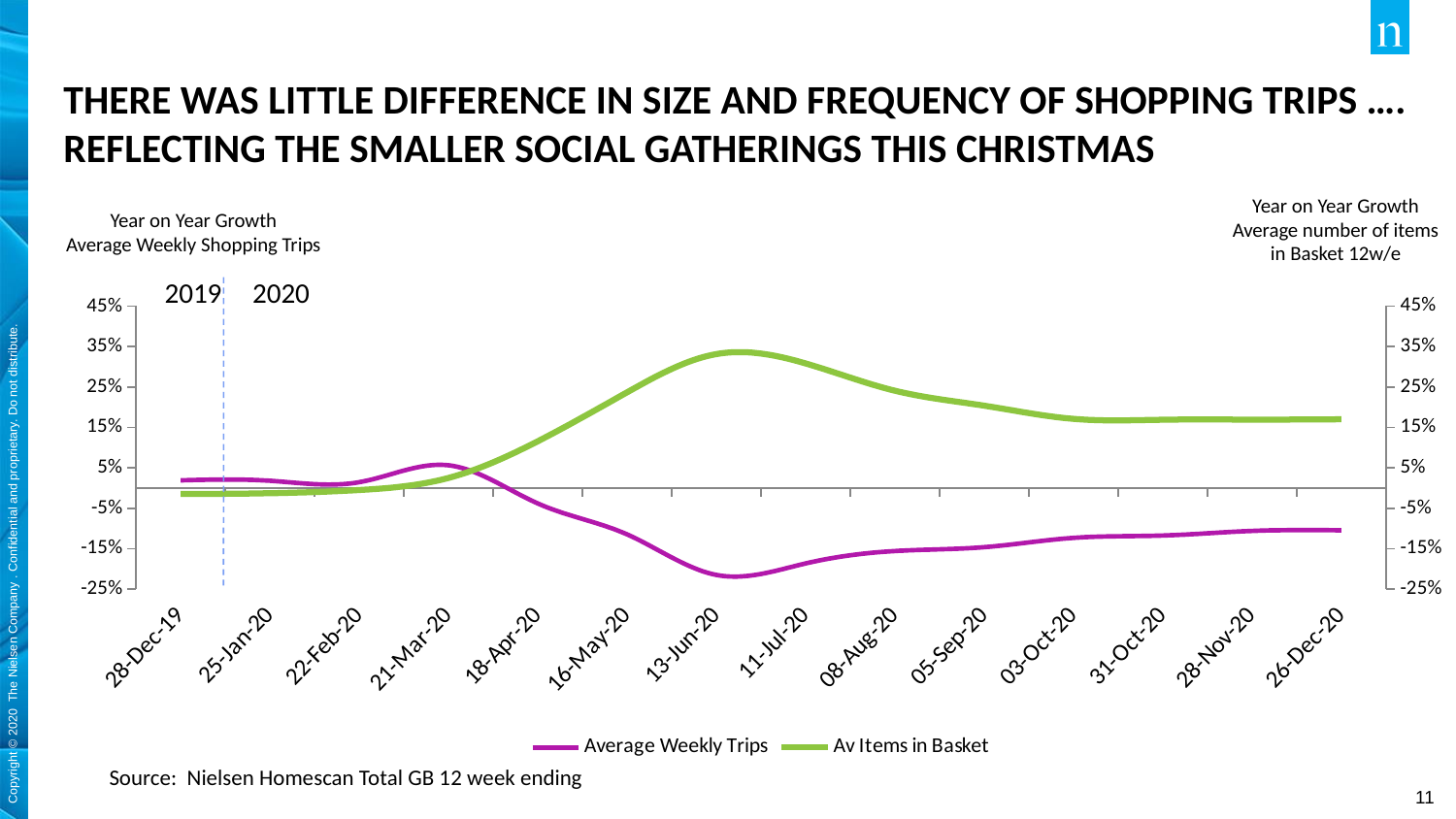
How many series does the legend list? 2 At 13-Jun-20, which series has the higher value, Average Weekly Trips or Av Items in Basket? Av Items in Basket How many dates are labelled along the x axis? 14 Is the value for Av Items in Basket at 13-Jun-20 greater or less than 25%? greater What colour is the Av Items in Basket line? Green At which date does the Av Items in Basket line reach its highest value? 13-Jun-20 Is the value for Average Weekly Trips at 26-Dec-20 greater or less than -5%? less Does the Av Items in Basket line rise or fall between 13-Jun-20 and 26-Dec-20? Fall Is the value for Average Weekly Trips at 13-Jun-20 greater or less than -15%? less At which date does the Average Weekly Trips line reach its lowest value? 13-Jun-20 What kind of chart is shown on the slide? Line chart